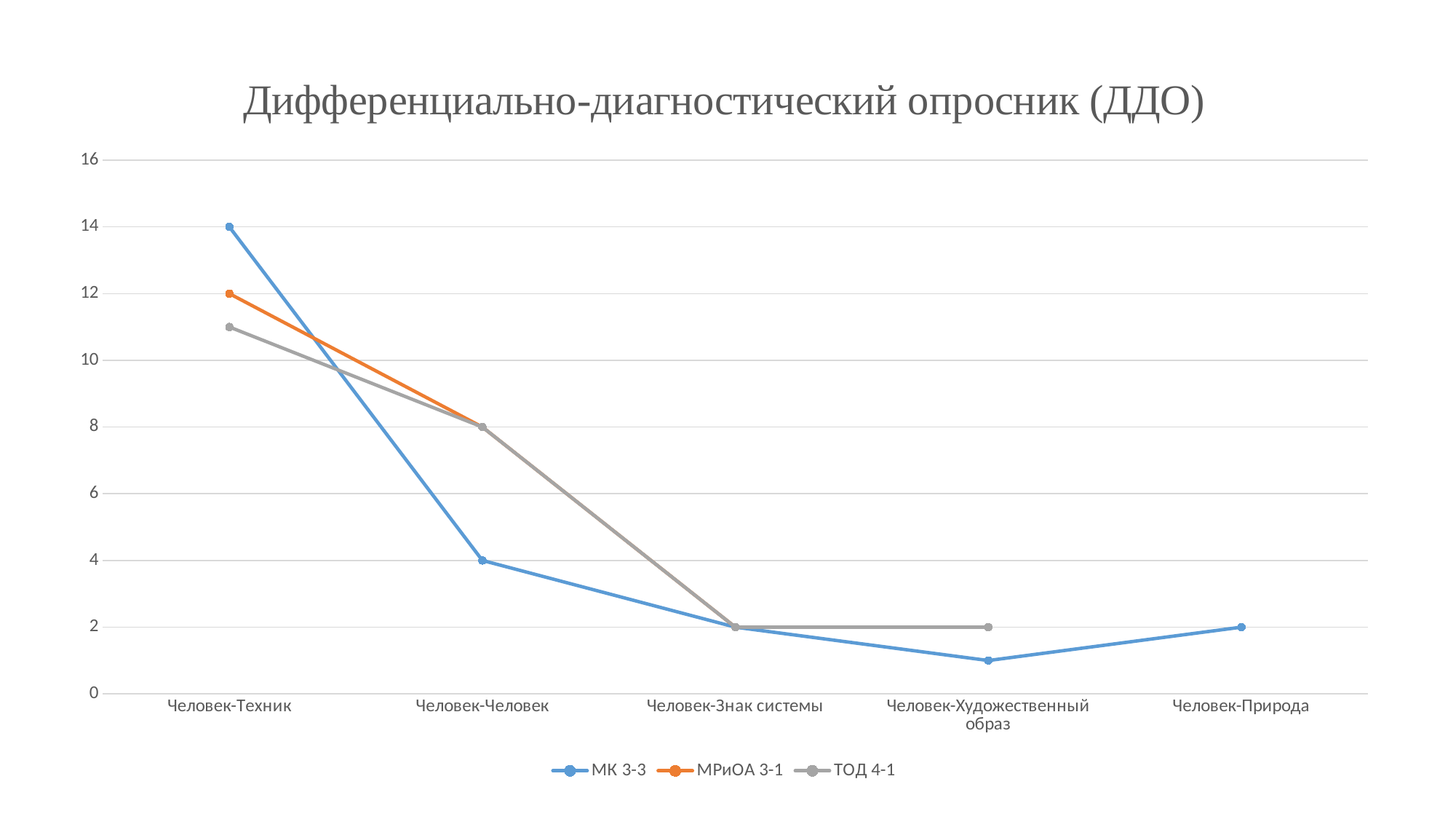
Is the value for ТОД 4-1 at Человек-Техник greater or less than 10? greater What is the title of the chart? Дифференциально-диагностический опросник (ДДО) Which series has the highest value at Человек-Техник? МК 3-3 What is the value for МК 3-3 at Человек-Техник? 14 How many categories are shown on the x axis? 5 What is the value for ТОД 4-1 at Человек-Человек? 8 What is the value for МРиОА 3-1 at Человек-Техник? 12 How many series does the legend list? 3 Is the value for МК 3-3 at Человек-Художественный образ greater or less than 2? less What is the difference between the МК 3-3 values at Человек-Техник and Человек-Человек? 10 What kind of chart is shown on the slide? line chart What is the value for МК 3-3 at Человек-Человек? 4